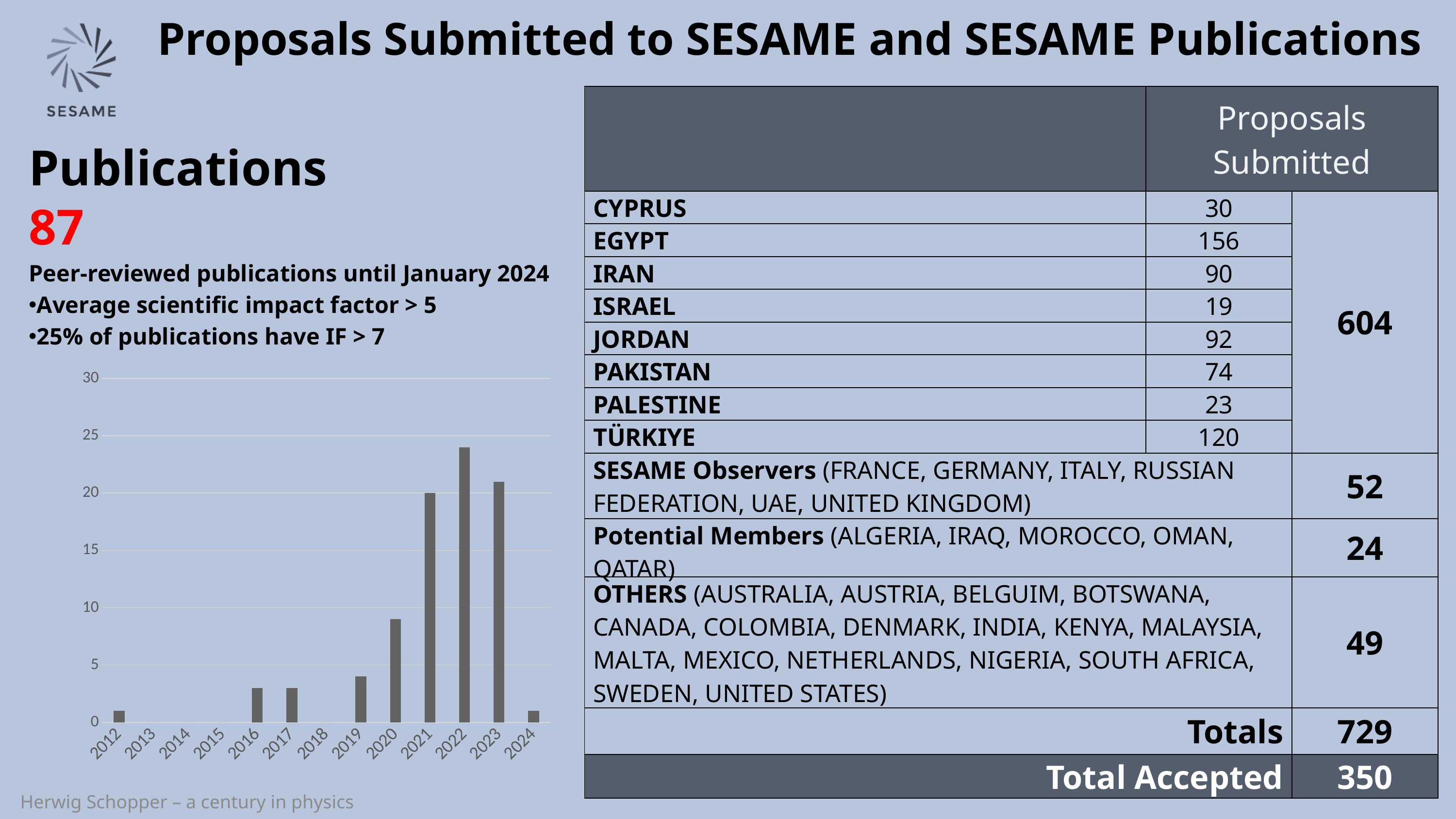
How many years are shown on the x axis of the publications bar chart? 13 In the publications bar chart, is the value for 2020 greater or less than 10? less In the publications bar chart, is the value for 2022 greater or less than 20? greater What kind of chart is shown on the left of the slide under the Publications heading? bar chart In the publications bar chart, which year has the larger value, 2019 or 2020? 2020 In the publications bar chart, is the value for 2019 greater or less than 5? less In the publications bar chart, do the values rise or fall from 2019 to 2022? rise What is the first year shown on the x axis of the publications bar chart? 2012 In the publications bar chart, which year has the larger value, 2022 or 2023? 2022 In the publications bar chart, which year has the highest bar? 2022